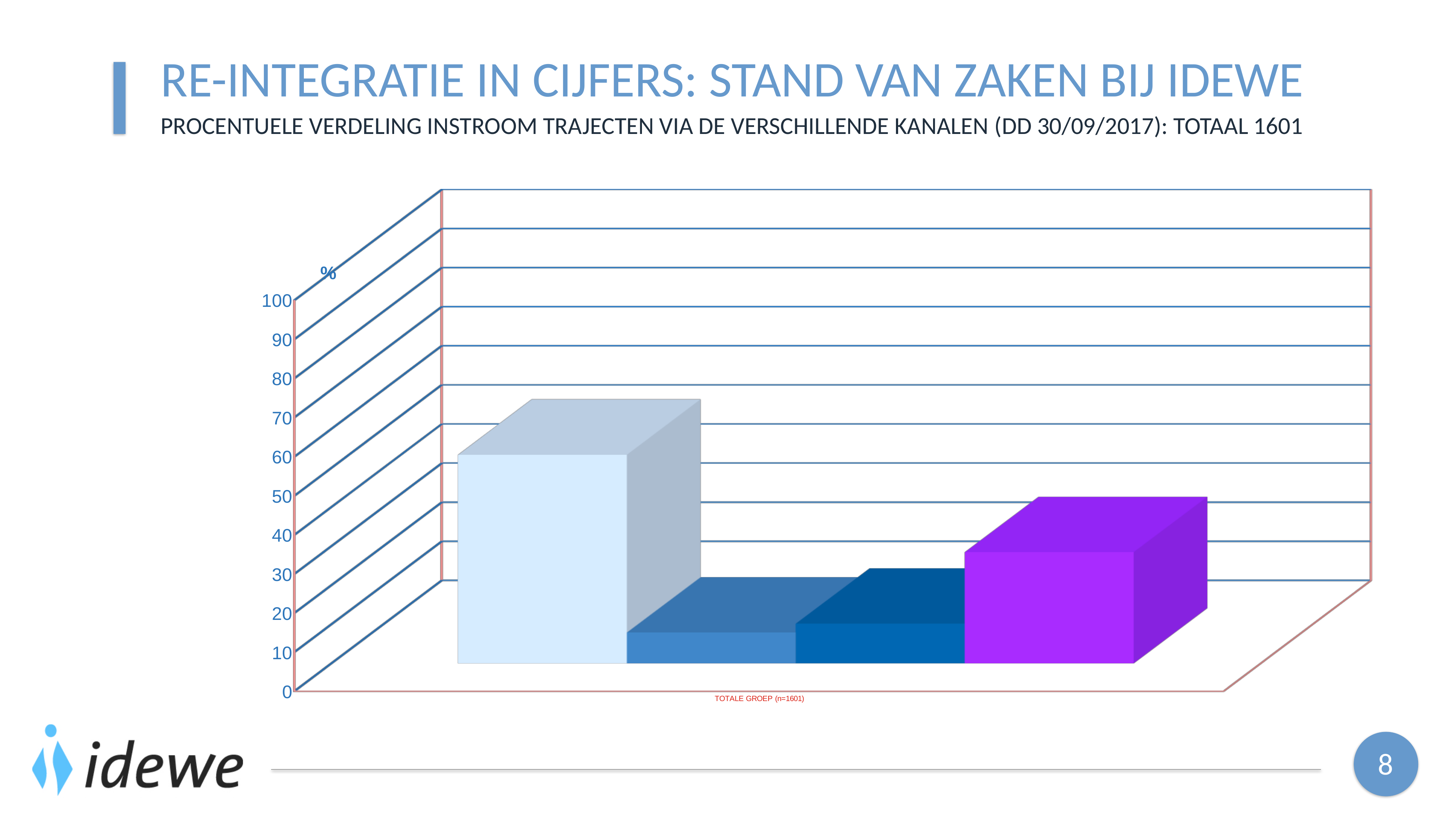
What is the label shown on the category axis of the chart? TOTALE GROEP (n=1601) Which is larger, the light blue bar or the purple bar? the light blue bar Is the value of the second (medium blue) bar greater or less than 30? less Is the value of the leftmost light blue bar greater or less than 50? greater What kind of chart is shown on the slide? bar chart Is the value of the third (dark blue) bar greater or less than 30? less What is the highest value shown on the vertical axis of the chart? 100 Which is larger, the purple bar or the dark blue bar? the purple bar Which bar is the highest in the chart? the leftmost (light blue) bar How many bars are plotted in the chart? 4